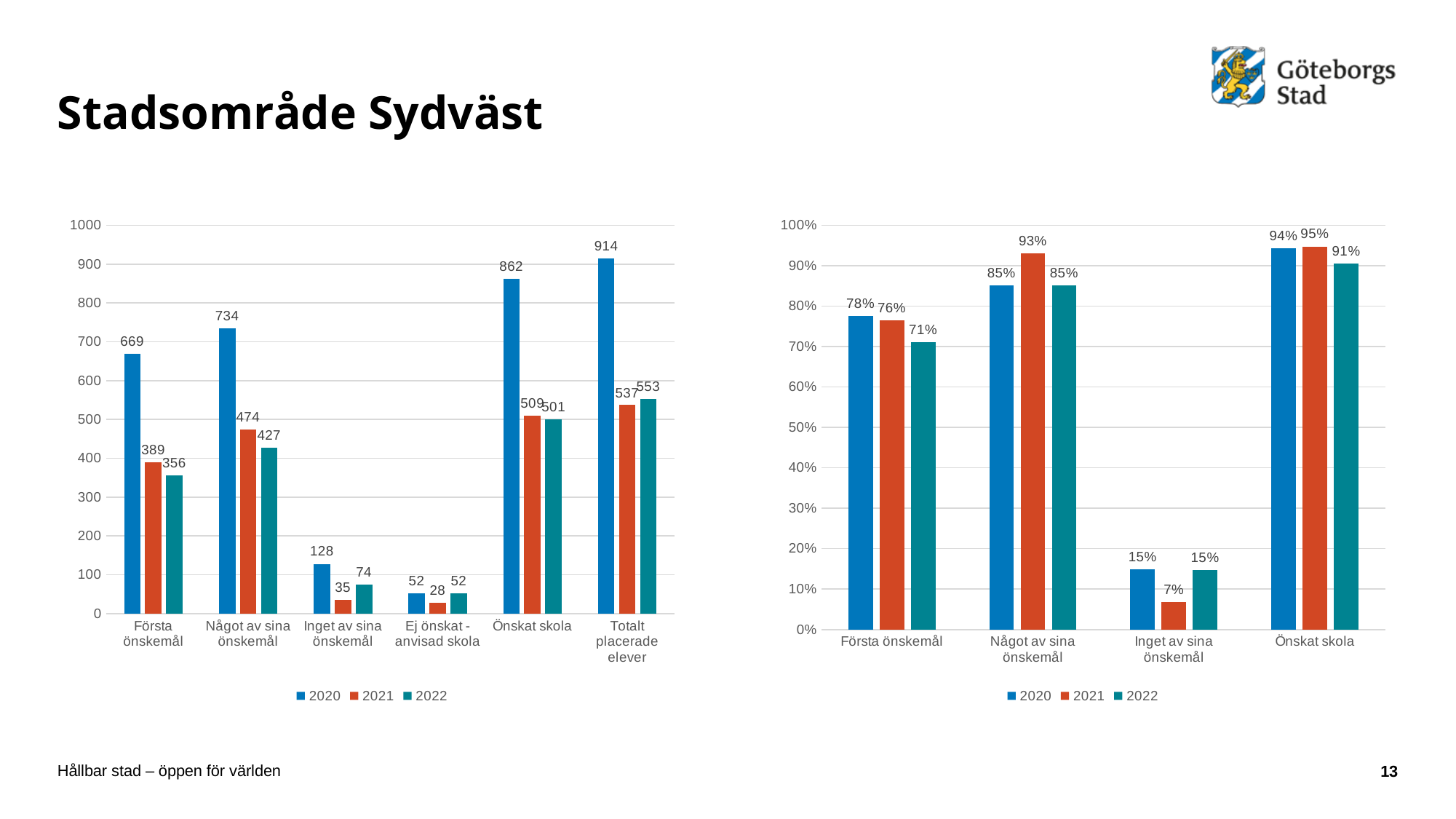
What kind of chart is the left chart? Bar chart In the left chart, which category has the lowest value for 2021? Ej önskat - anvisad skola In the left chart, what is the value for 2020 in the 'Totalt placerade elever' category? 914 In the right chart, what is the difference between the 2020 and 2022 values for 'Första önskemål'? 7% In the right chart, what is the value for 2021 in the 'Något av sina önskemål' category? 93% In the left chart, what is the difference between the 2020 and 2021 values for 'Första önskemål'? 280 In the left chart, which is larger for 'Önskat skola': the 2021 value or the 2022 value? 2021 In the right chart, what is the value for 2022 in the 'Önskat skola' category? 91% In the right chart, which category has the highest value for 2020? Önskat skola How many series does the legend of the left chart list? 3 In the left chart, what is the value for 2022 in the 'Första önskemål' category? 356 How many categories are shown on the x axis of the right chart? 4